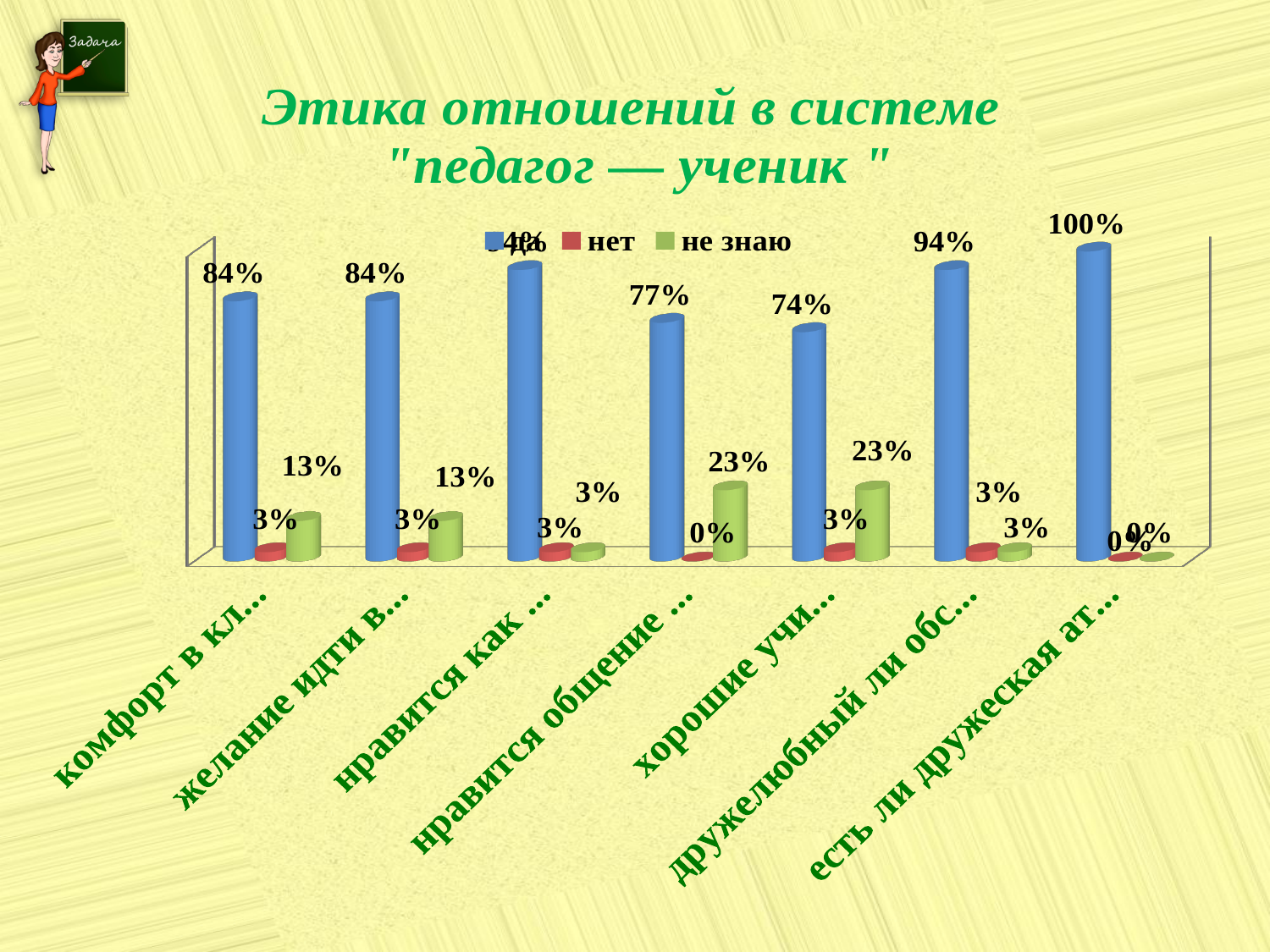
Which is larger: the "не знаю" value for "комфорт в кл..." or for "нравится общение ..."? нравится общение ... What is the value of "не знаю" for the category "хорошие учи..."? 23% What is the value of "да" for the category "нравится общение ..."? 77% Which category has the highest value for "да"? есть ли дружеская ат... What is the difference between the "да" values for "дружелюбный ли обс..." and "хорошие учи..."? 20% How many series does the legend list? 3 Which series is shown in green in the legend? не знаю What kind of chart is shown on the slide? bar chart What is the value of "нет" for the category "комфорт в кл..."? 3% How many categories are shown along the x axis? 7 What is the value of "да" for the category "есть ли дружеская ат..."? 100% Which category has the lowest value for "да"? хорошие учи...